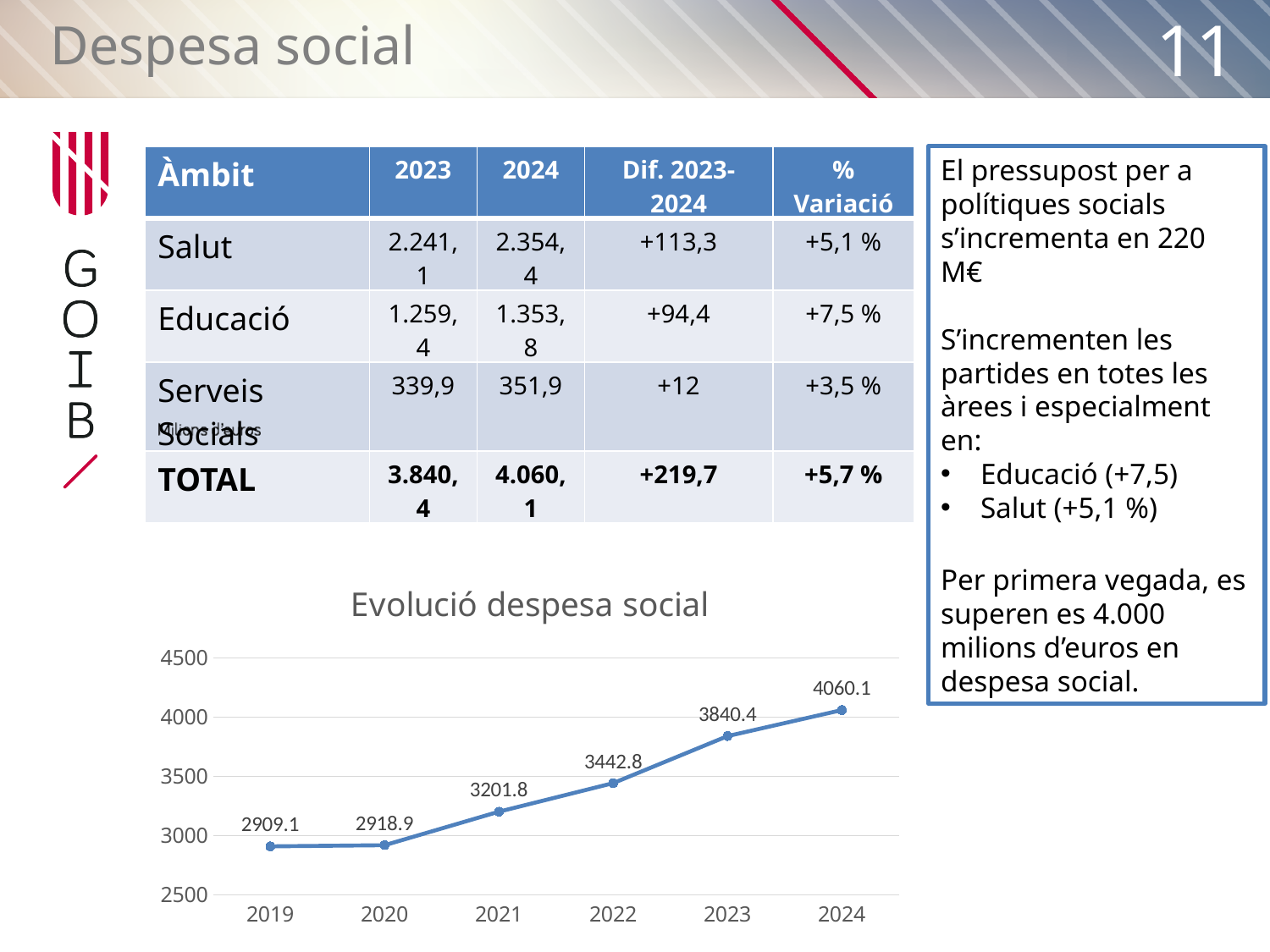
Which is larger in the chart, the value for 2022 or the value for 2023? 2023 What is the value for 2019 in the chart? 2909.1 What is the title of the chart on the slide? Evolució despesa social What is the difference between the values for 2024 and 2023 in the chart? 219.7 What is the difference between the values for 2022 and 2021 in the chart? 241 How many years are plotted in the chart? 6 Which year has the lowest value in the chart? 2019 Is the value for 2023 in the chart greater or less than 4000? less What kind of chart is shown on the slide? line chart What is the value for 2021 in the chart? 3201.8 What is the value for 2024 in the chart? 4060.1 Which year has the highest value in the chart? 2024